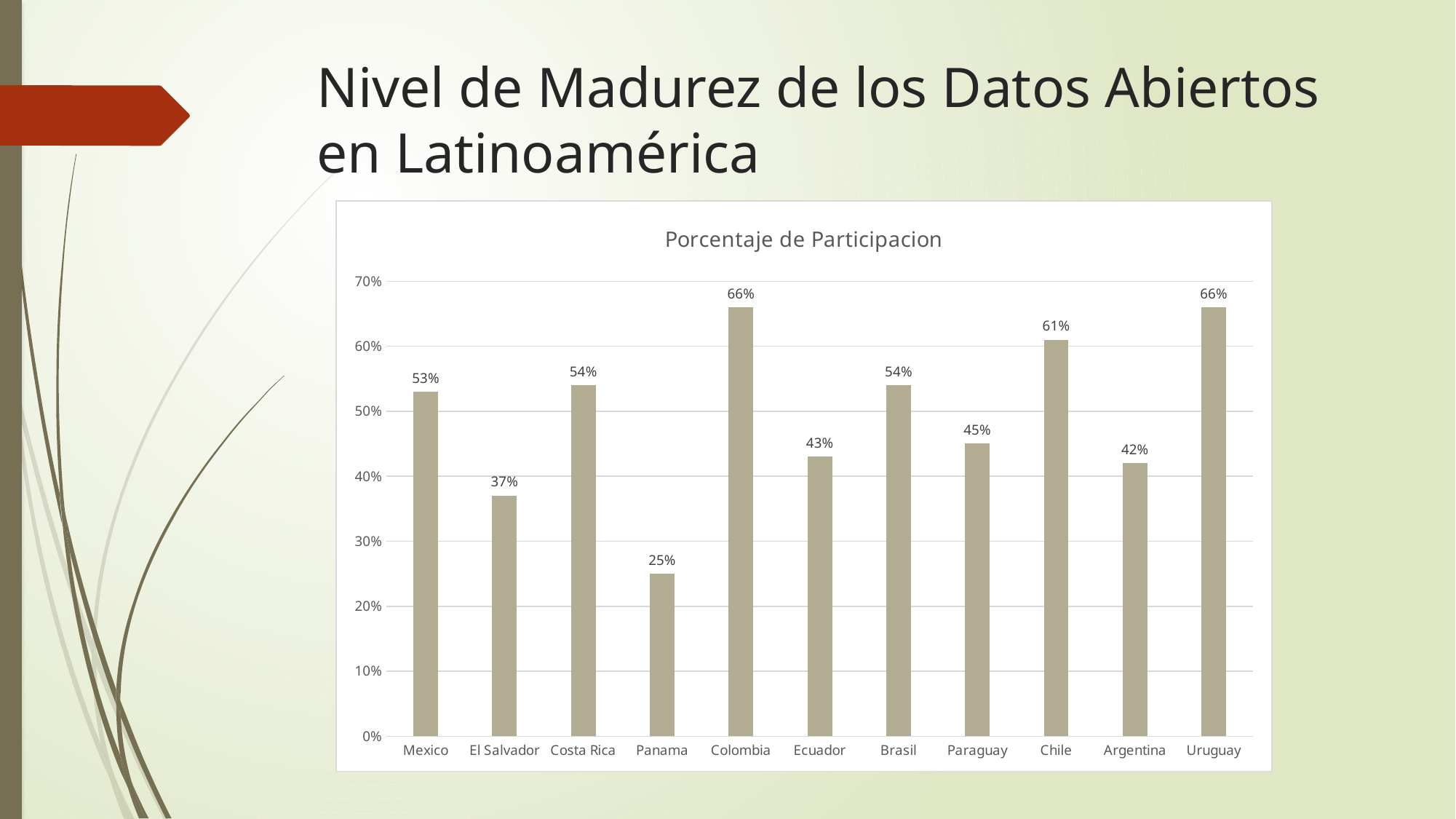
What is the difference between the values for Colombia and El Salvador? 29% What is the value for Panama? 25% Which is larger, the value for El Salvador or the value for Brasil? Brasil What is the title of the chart? Porcentaje de Participacion How many countries are shown on the x axis? 11 What is the value for Chile? 61% Which country has the lowest value? Panama What kind of chart is shown on the slide? Bar chart What is the value for Mexico? 53% Which is larger, the value for Paraguay or the value for Argentina? Paraguay What is the value for Ecuador? 43% What is the difference between the values for Chile and Argentina? 19%